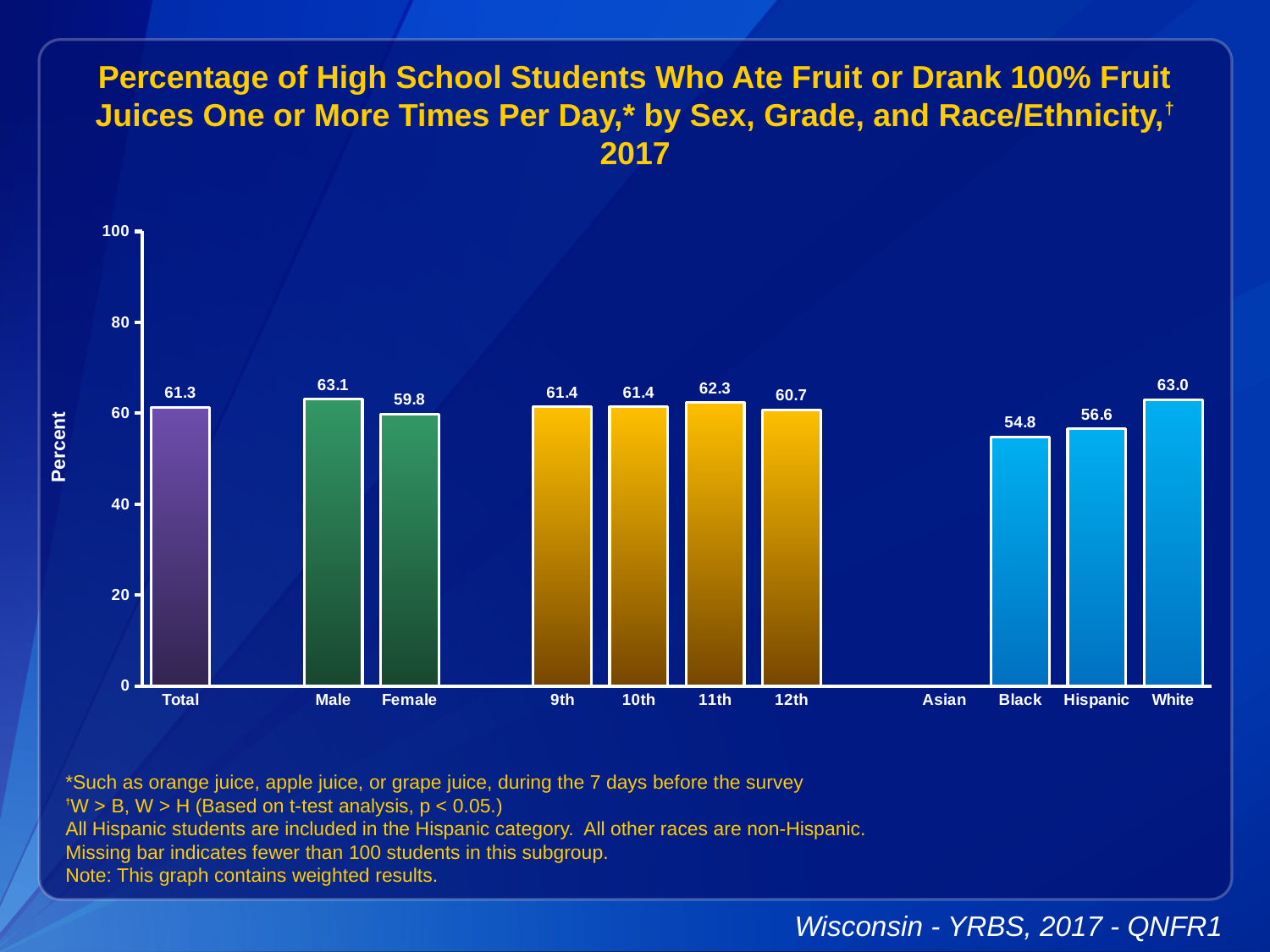
What is the value for Female? 59.8 What is the value for 11th grade? 62.3 Which category has the lowest value? Black Is the value for Black greater or less than 60? less What is the value for Total? 61.3 Which category label has no bar shown? Asian What kind of chart is shown on the slide? bar chart Which is larger, the value for 12th grade or the value for Hispanic? 12th What is the value for Black students? 54.8 What is the difference between the values for White and Hispanic? 6.4 Which category has the highest value? Male What is the difference between the values for Male and Female? 3.3